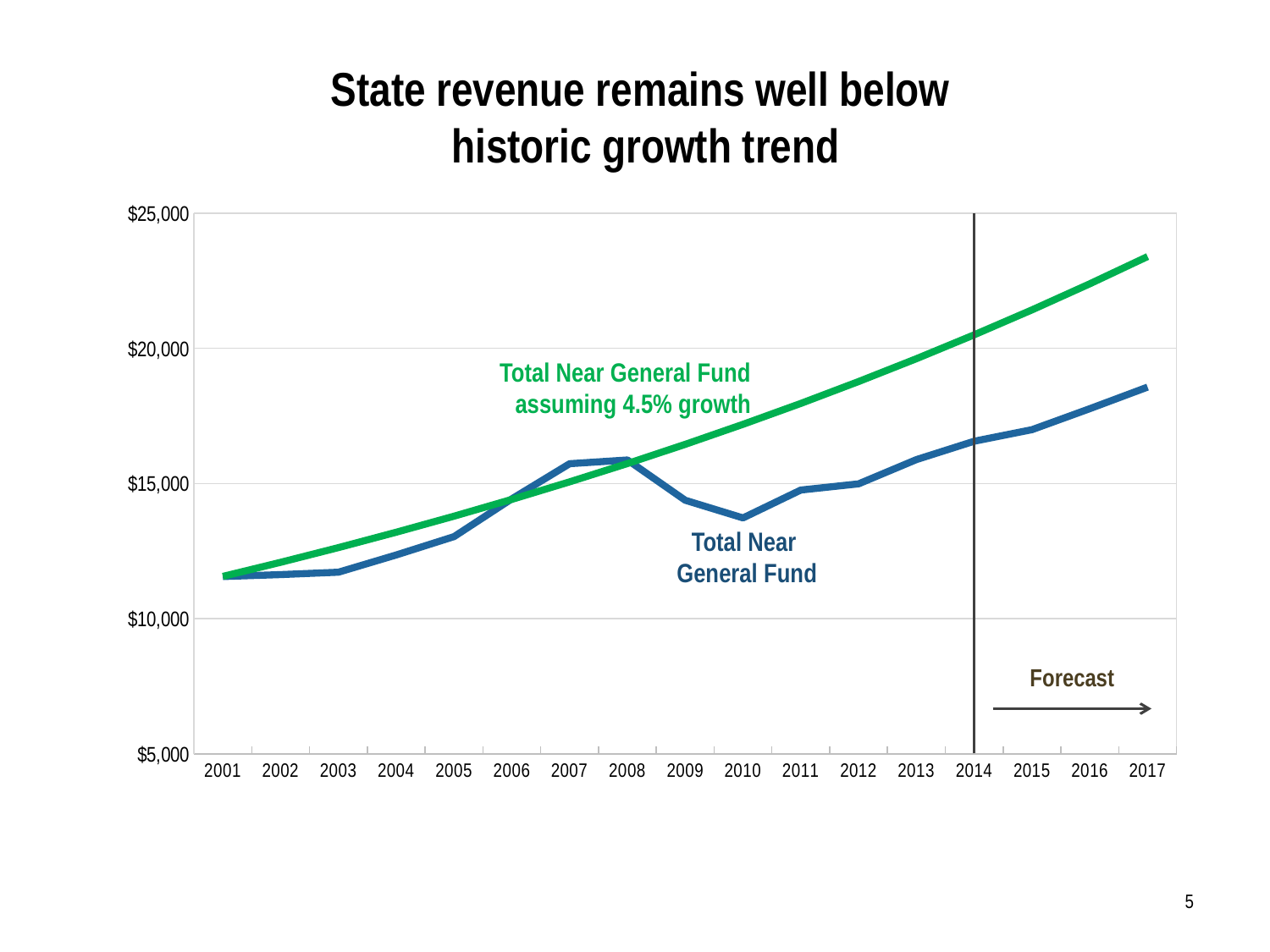
Is the value of Total Near General Fund assuming 4.5% growth in 2017 greater or less than $20,000? greater How many series are plotted on the chart? 2 What kind of chart is shown on the slide? Line chart In 2017, which series has the higher value: Total Near General Fund or Total Near General Fund assuming 4.5% growth? Total Near General Fund assuming 4.5% growth Is the value of Total Near General Fund in 2010 greater or less than $15,000? less In which year does the Total Near General Fund line reach its lowest value? 2001 How many years are shown along the x axis? 17 Does the Total Near General Fund line rise or fall between 2008 and 2010? fall In which year does the Total Near General Fund assuming 4.5% growth line reach its highest value? 2017 Is the value of Total Near General Fund in 2017 greater or less than $20,000? less At which year is the vertical line marking the start of the forecast period drawn? 2014